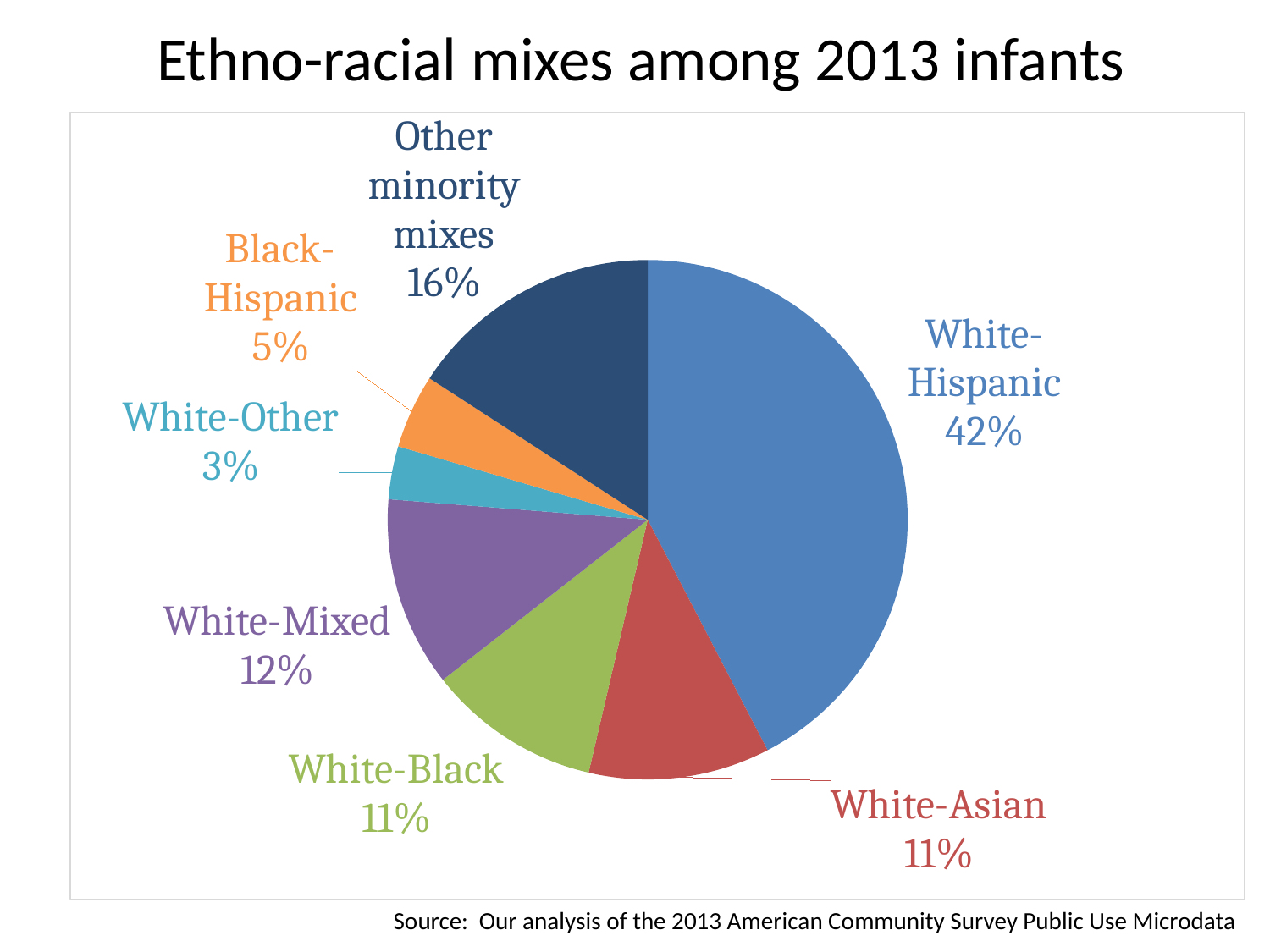
Which category has the smallest slice of the pie? White-Other Which is larger, the White-Mixed slice or the Black-Hispanic slice? White-Mixed What percentage is shown for Black-Hispanic? 5% How many slices does the pie chart have? 7 What is the combined share of White-Black and White-Asian? 22% What kind of chart is shown on the slide? Pie chart What is the title of the chart? Ethno-racial mixes among 2013 infants What share of 2013 infants were White-Hispanic? 42% What percentage is shown for Other minority mixes? 16% Which category has the largest slice of the pie? White-Hispanic What percentage is shown for White-Mixed? 12% What is the difference in percentage points between White-Hispanic and Other minority mixes? 26